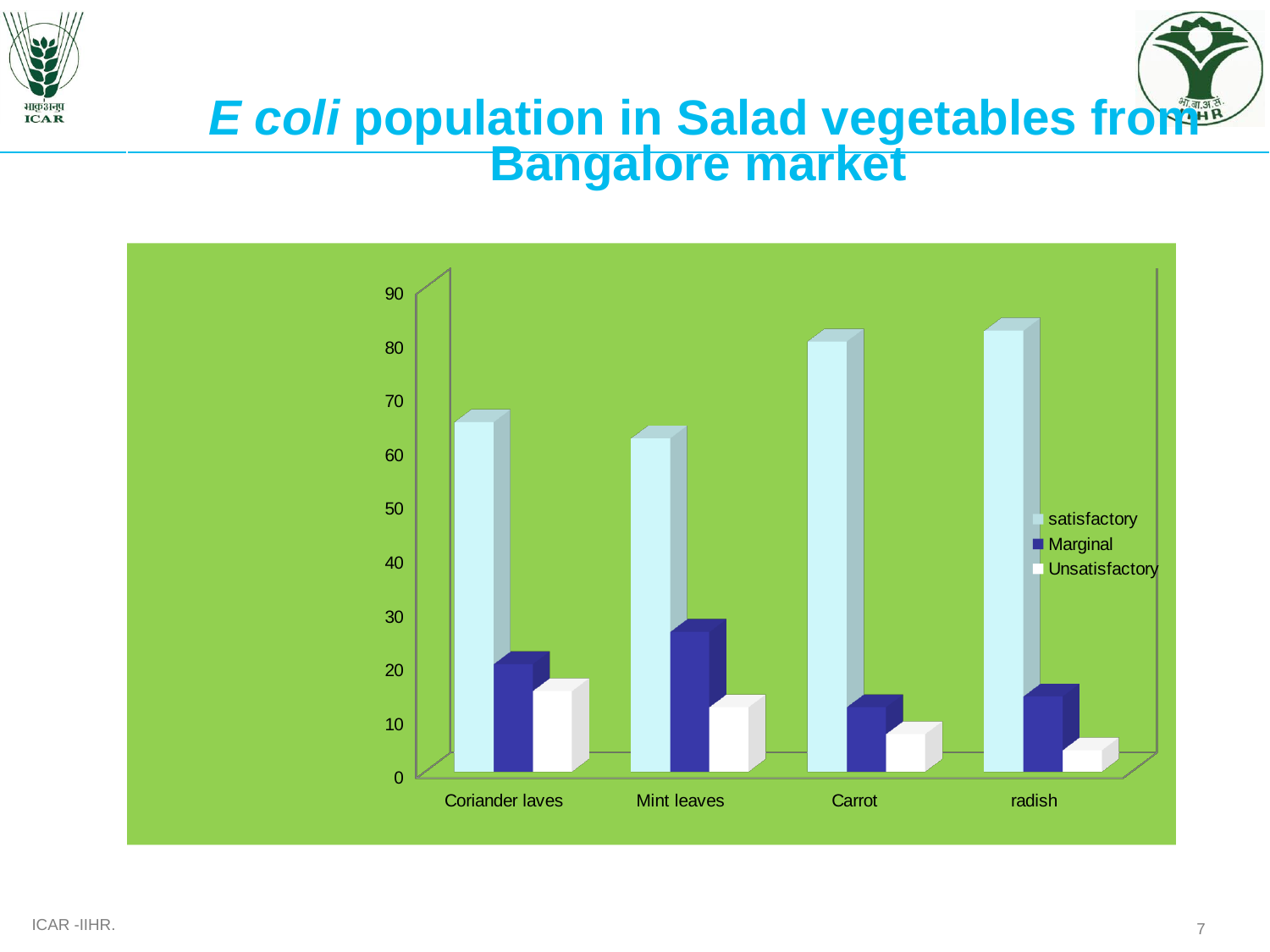
How many vegetable categories are shown on the x axis? 4 Which has the larger satisfactory value, Carrot or Coriander laves? Carrot What kind of chart is shown on the slide? bar chart What are the three series named in the legend? satisfactory, Marginal, Unsatisfactory Is the Marginal value for Carrot greater or less than 20? less Is the satisfactory value for Carrot greater or less than 70? greater Which vegetable has the lowest Unsatisfactory value? radish Is the Unsatisfactory value for radish greater or less than 10? less How many series does the legend list? 3 Which vegetable has the highest Marginal value? Mint leaves Which has the larger Marginal value, Mint leaves or Carrot? Mint leaves